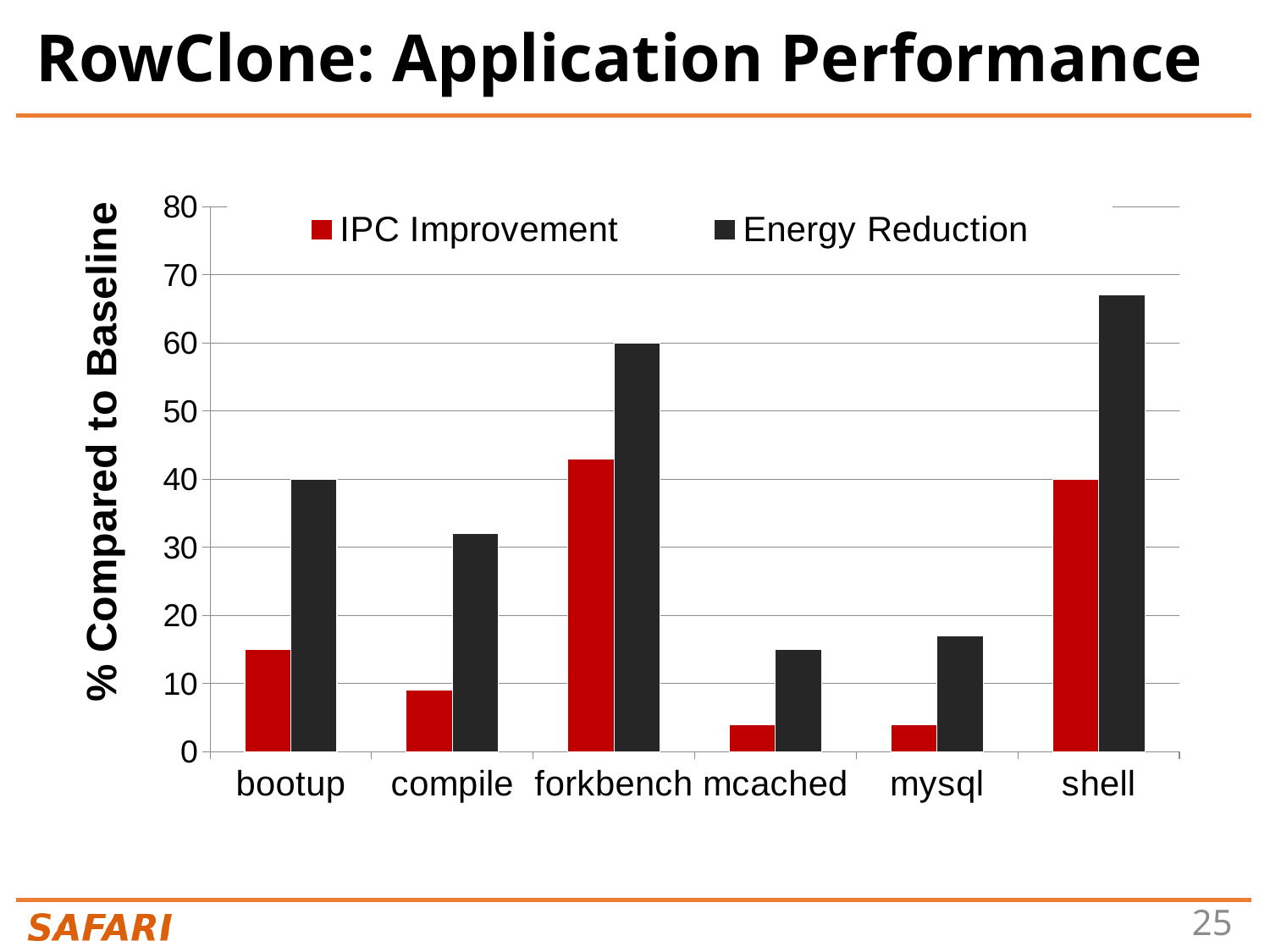
What kind of chart is shown on the slide? bar chart Is the IPC Improvement for mysql greater or less than 10? less Which application has the highest Energy Reduction? shell Which is larger, the Energy Reduction for forkbench or for mcached? forkbench Is the Energy Reduction for shell greater or less than 60? greater Which application has the highest IPC Improvement? forkbench Is the IPC Improvement for forkbench greater or less than 40? greater Which is larger, the IPC Improvement for bootup or for compile? bootup How many applications are shown along the x axis? 6 What colour are the IPC Improvement bars? red How many series does the legend list? 2